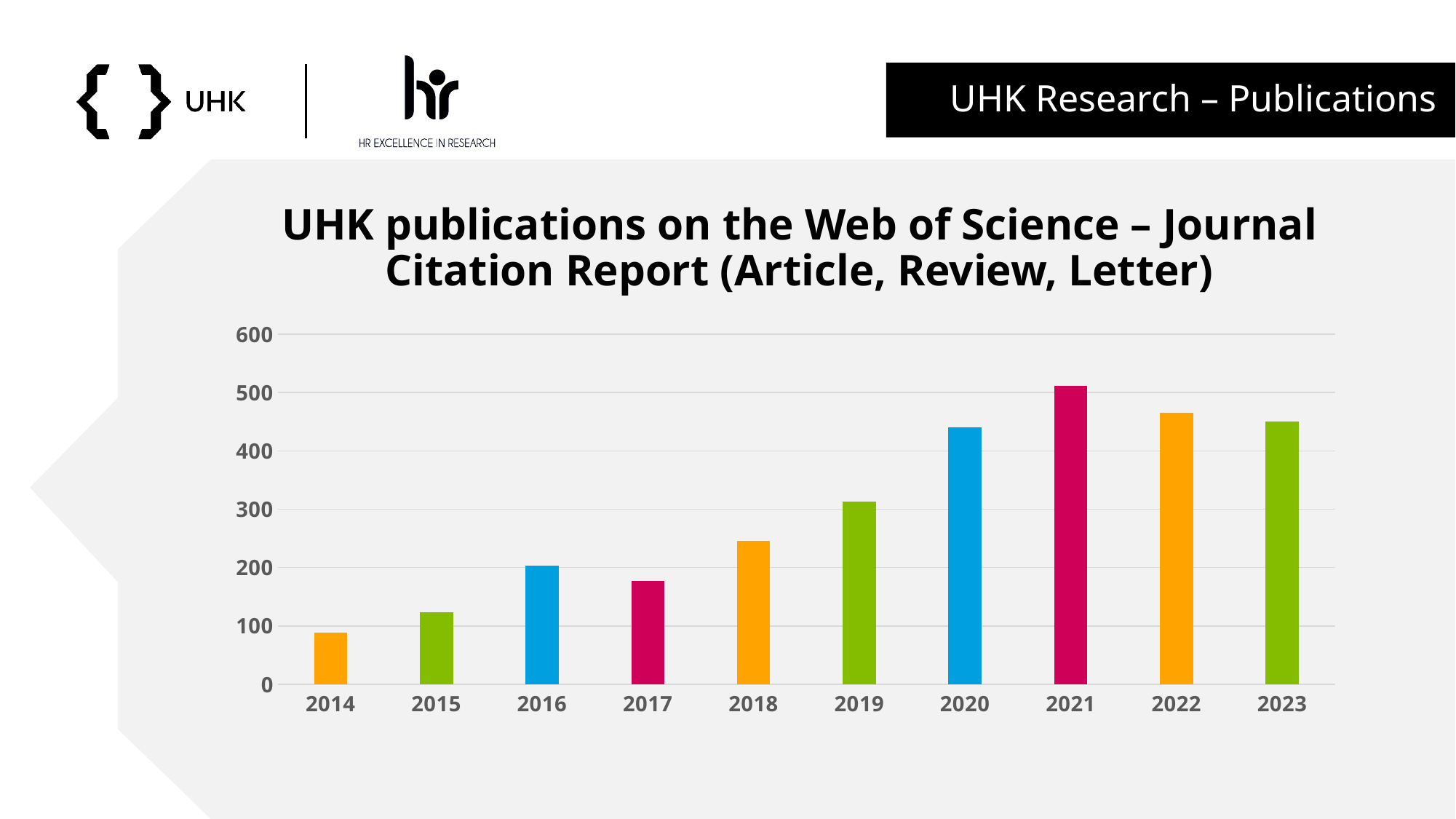
Is the value for 2014 greater or less than 100? less How many years are shown on the x axis of the chart? 10 Which year has the highest number of UHK publications in the chart? 2021 What kind of chart is shown on the slide? bar chart What is the title of the chart? UHK publications on the Web of Science – Journal Citation Report (Article, Review, Letter) Is the value for 2019 greater or less than 300? greater Do the values generally rise or fall from 2014 to 2021? rise Is the value for 2021 greater or less than 500? greater Which year has the lowest number of UHK publications in the chart? 2014 Which year has the larger value, 2016 or 2017? 2016